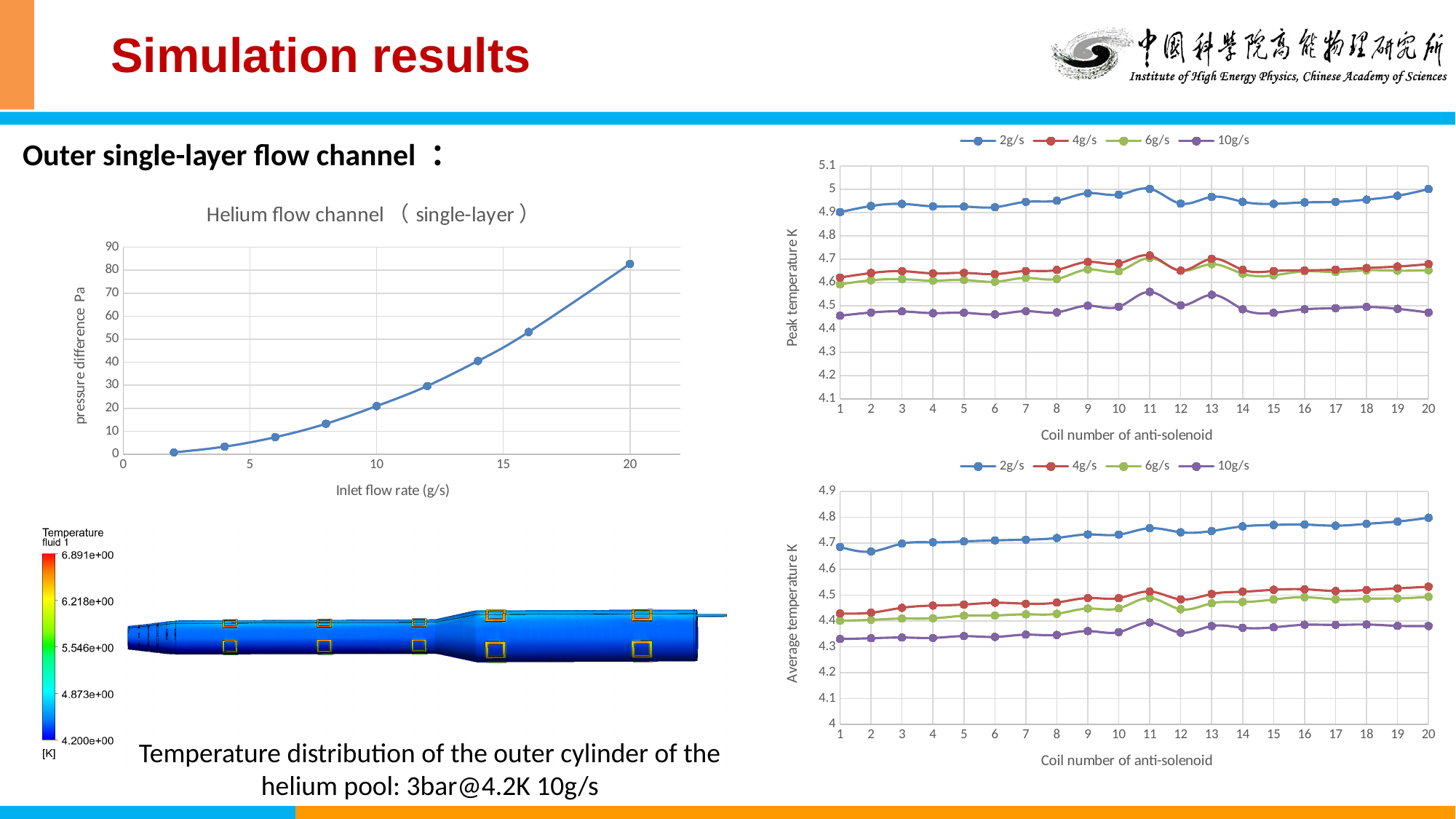
In the top-right 'Peak temperature K' chart, is the 2g/s value at coil number 20 greater or less than 4.9 K? greater In the top-right 'Peak temperature K' chart, how many series does the legend list? 4 What is the x-axis title of the bottom-right 'Average temperature K' chart? Coil number of anti-solenoid What kind of chart is the 'Helium flow channel (single-layer)' chart on the left? line chart In the 'Helium flow channel (single-layer)' chart, does the pressure difference rise or fall as the inlet flow rate increases? rise In the top-right 'Peak temperature K' chart, which series has the lowest peak temperature across the coils? 10g/s In the bottom-right 'Average temperature K' chart, how many coil numbers are shown on the x axis? 20 In the 'Helium flow channel (single-layer)' chart, is the pressure difference at an inlet flow rate of 10 g/s greater or less than 30 Pa? less In the top-right 'Peak temperature K' chart, which series has the highest peak temperature across the coils? 2g/s In the 'Helium flow channel (single-layer)' chart, is the pressure difference at an inlet flow rate of 20 g/s greater or less than 70 Pa? greater In the 'Helium flow channel (single-layer)' chart, how many data points are plotted? 9